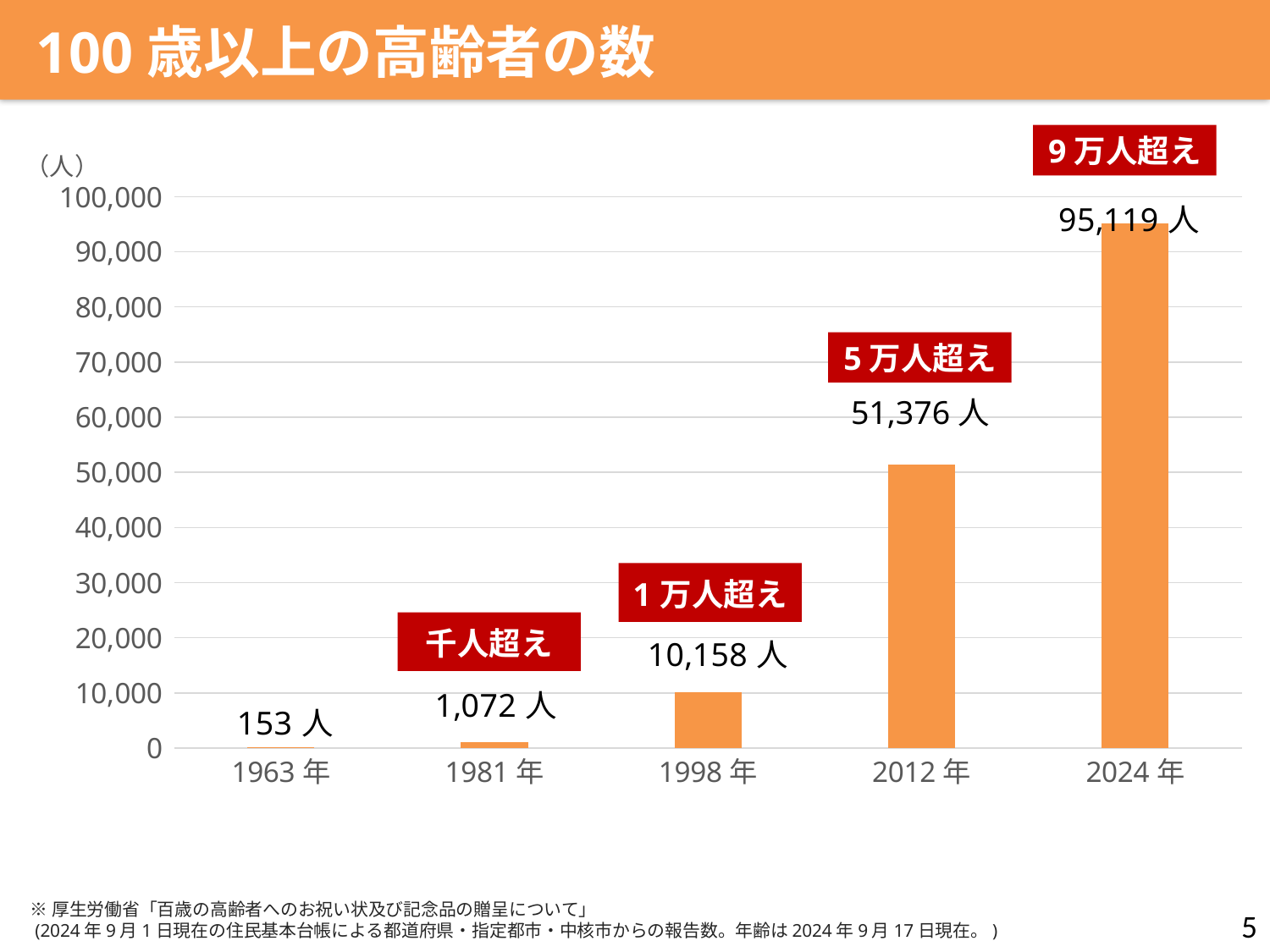
Which year has the lowest value? 1963 年 What kind of chart is this? Bar chart Which year has the highest value? 2024 年 What is the value for 2024 年? 95,119 人 What is the difference between the values for 2024 年 and 2012 年? 43,743 人 What is the value for 2012 年? 51,376 人 How many years are shown on the x axis? 5 What is the difference between the values for 1998 年 and 1981 年? 9,086 人 What is the value for 1963 年? 153 人 Which is larger, the value for 1981 年 or the value for 1998 年? 1998 年 Do the values rise or fall from 1963 年 to 2024 年? Rise What is the value for 1998 年? 10,158 人